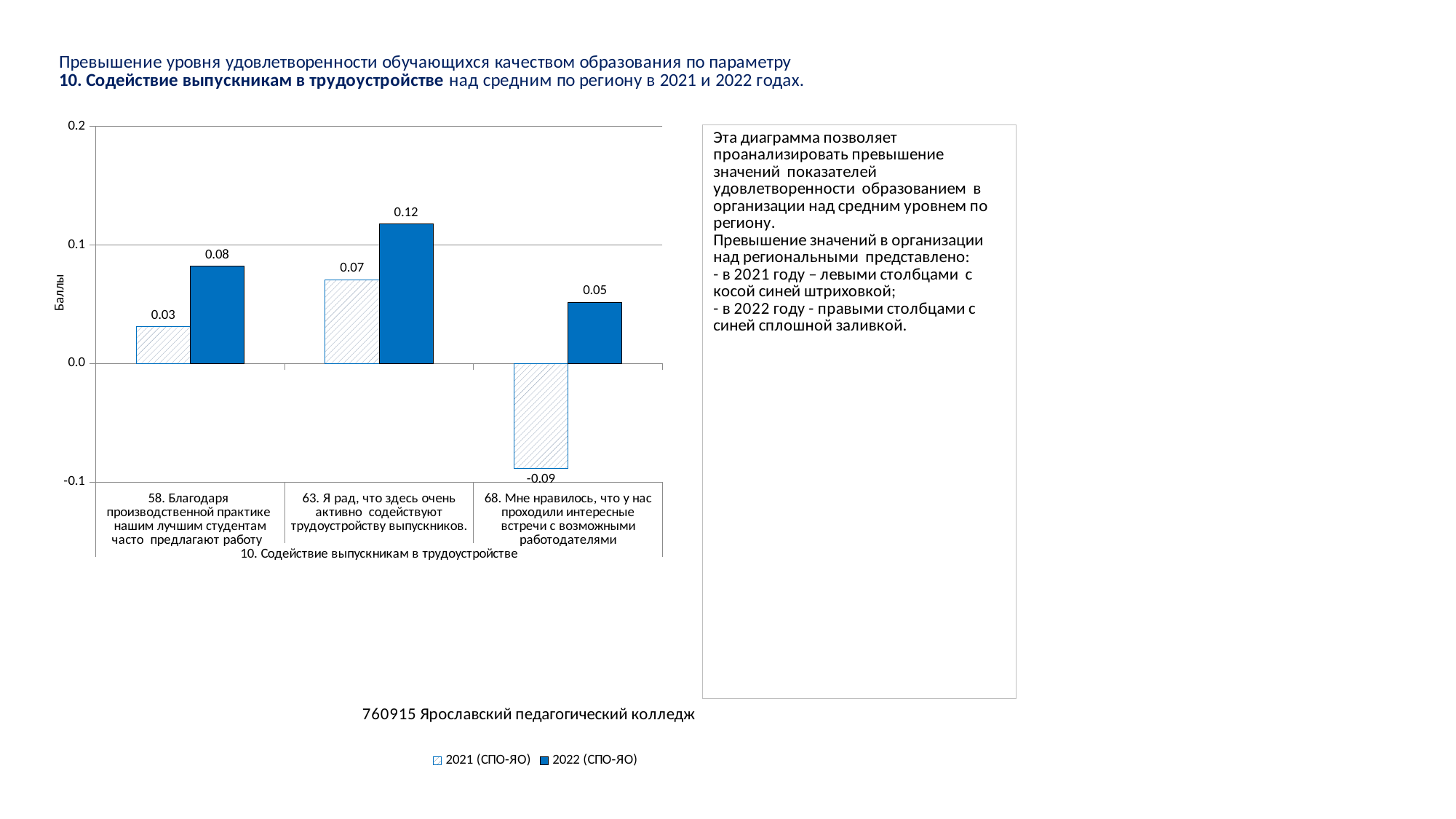
What is the 2022 (СПО-ЯО) value for category 63 (Я рад, что здесь очень активно содействуют трудоустройству выпускников)? 0.12 What is the difference between the 2022 and 2021 values for category 58? 0.05 What is the 2021 (СПО-ЯО) value for category 58 (Благодаря производственной практике нашим лучшим студентам часто предлагают работу)? 0.03 What is the 2021 (СПО-ЯО) value for category 68 (Мне нравилось, что у нас проходили интересные встречи с возможными работодателями)? -0.09 What is the 2022 (СПО-ЯО) value for category 68? 0.05 What kind of chart is shown on the slide? Bar chart How many series does the legend list? 2 Which category has the highest 2022 (СПО-ЯО) value? 63. Я рад, что здесь очень активно содействуют трудоустройству выпускников. Which category has the lowest 2021 (СПО-ЯО) value? 68. Мне нравилось, что у нас проходили интересные встречи с возможными работодателями How many categories are shown on the x axis? 3 Which is larger for category 63: the 2021 value or the 2022 value? 2022 (0.12) What is the label of the y axis? Баллы